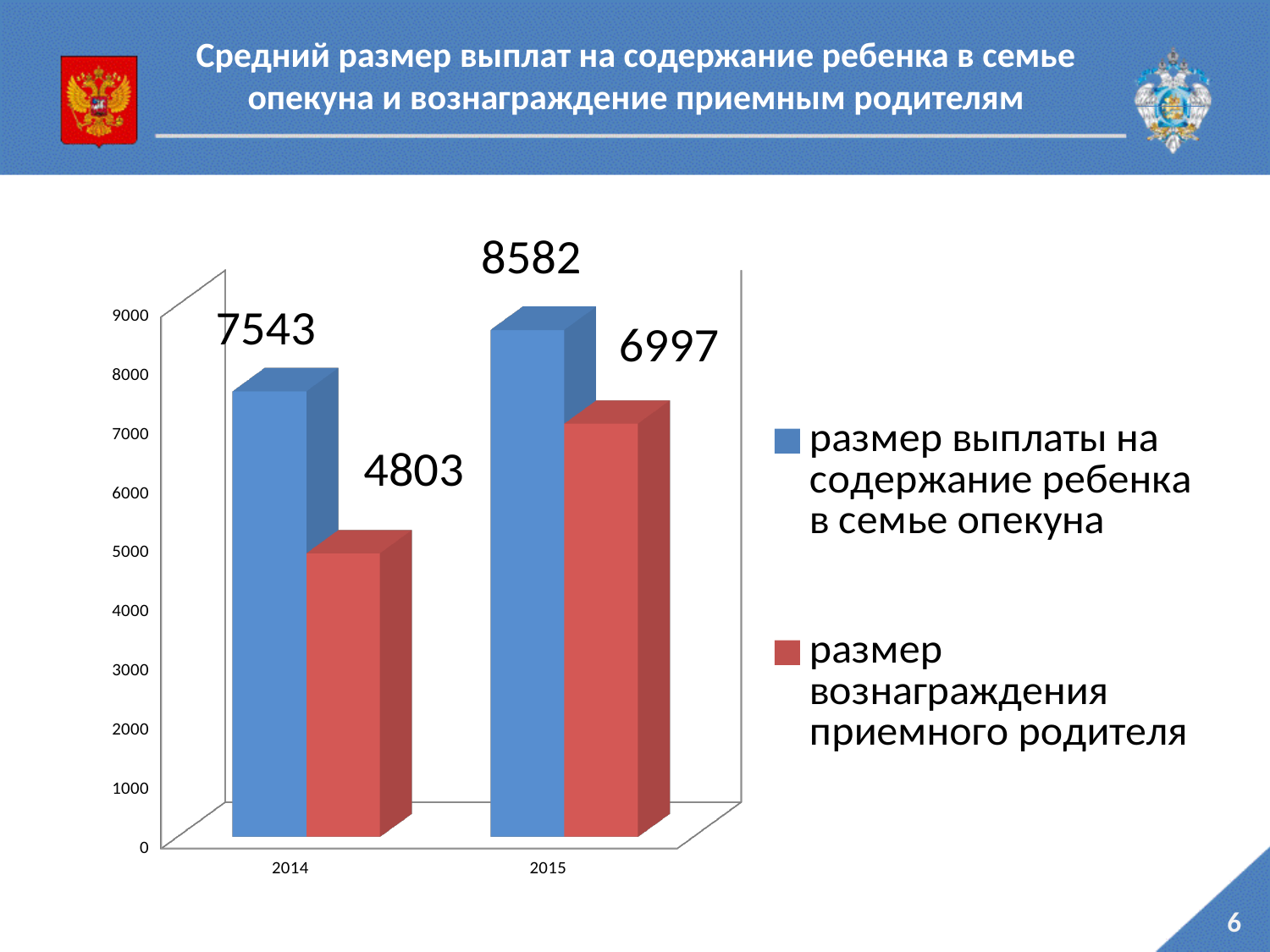
Which year has the highest value for 'размер выплаты на содержание ребенка в семье опекуна'? 2015 Which year has the lowest value for 'размер вознаграждения приемного родителя'? 2014 In 2015, which is larger: 'размер выплаты на содержание ребенка в семье опекуна' or 'размер вознаграждения приемного родителя'? размер выплаты на содержание ребенка в семье опекуна Does 'размер вознаграждения приемного родителя' rise or fall from 2014 to 2015? rise What is the value of 'размер выплаты на содержание ребенка в семье опекуна' for 2015? 8582 How many series does the legend list? 2 What is the value of 'размер вознаграждения приемного родителя' for 2015? 6997 What is the difference between the 2015 and 2014 values of 'размер вознаграждения приемного родителя'? 2194 What is the difference between the 2015 and 2014 values of 'размер выплаты на содержание ребенка в семье опекуна'? 1039 What is the value of 'размер выплаты на содержание ребенка в семье опекуна' for 2014? 7543 What kind of chart is shown on the slide? bar chart What is the value of 'размер вознаграждения приемного родителя' for 2014? 4803